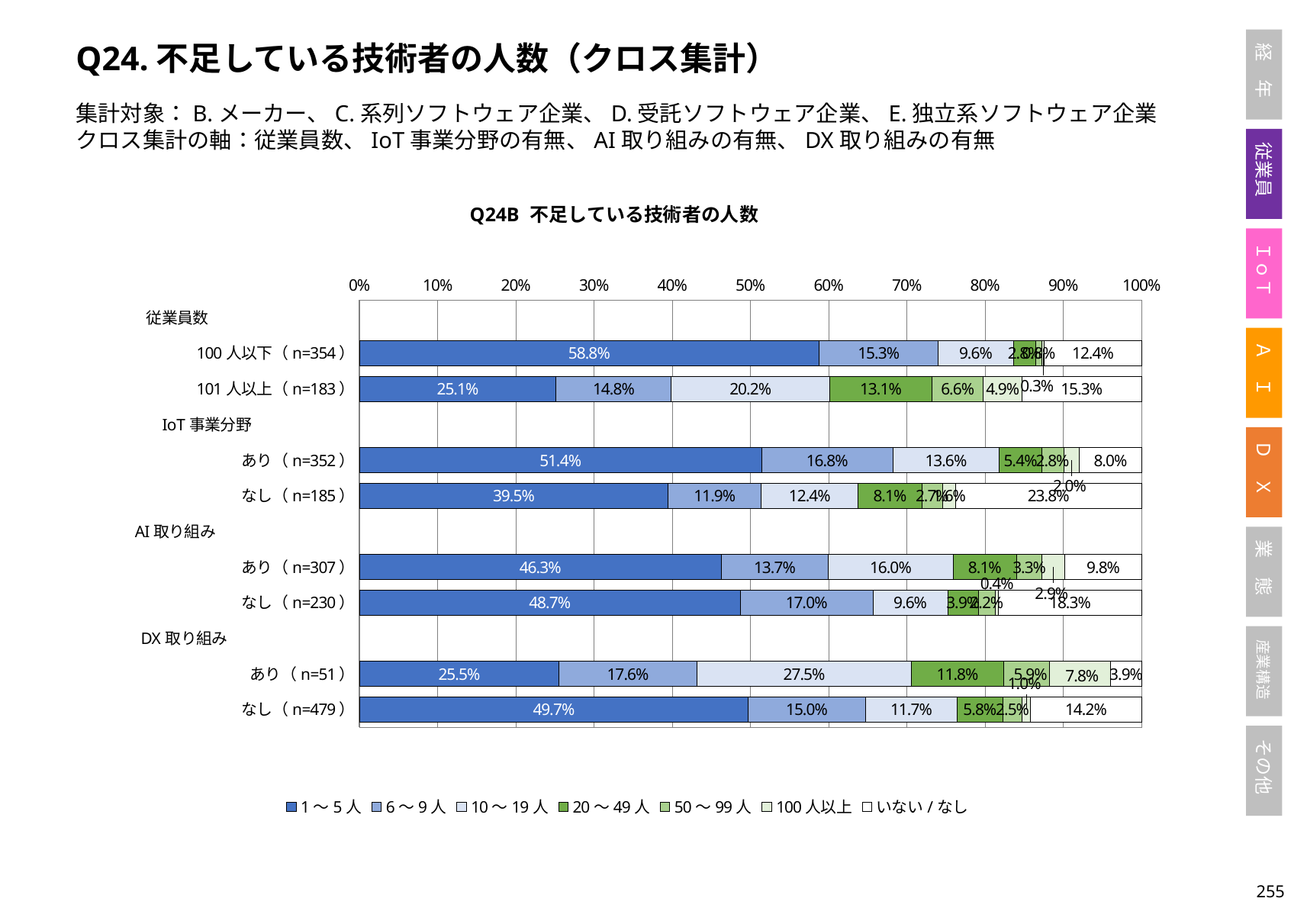
What is the value of 1～5人 for 100人以下 (n=354)? 58.8% What is the title of the chart? Q24B 不足している技術者の人数 What kind of chart is shown on the slide? Stacked bar chart How many series does the legend list? 7 Which group has the highest value for 1～5人? 100人以下 (n=354) What is the value of いない/なし for IoT事業分野 なし (n=185)? 23.8% What is the value of 10～19人 for 101人以上 (n=183)? 20.2% Which group has the lowest value for 1～5人? 101人以上 (n=183) How many bars (respondent groups) are plotted in the chart? 8 What is the value of 10～19人 for DX取り組み あり (n=51)? 27.5% What is the difference between the 1～5人 values for 100人以下 (n=354) and 101人以上 (n=183)? 33.7 percentage points Which is larger, the いない/なし value for IoT事業分野 あり (n=352) or for IoT事業分野 なし (n=185)? IoT事業分野 なし (n=185)